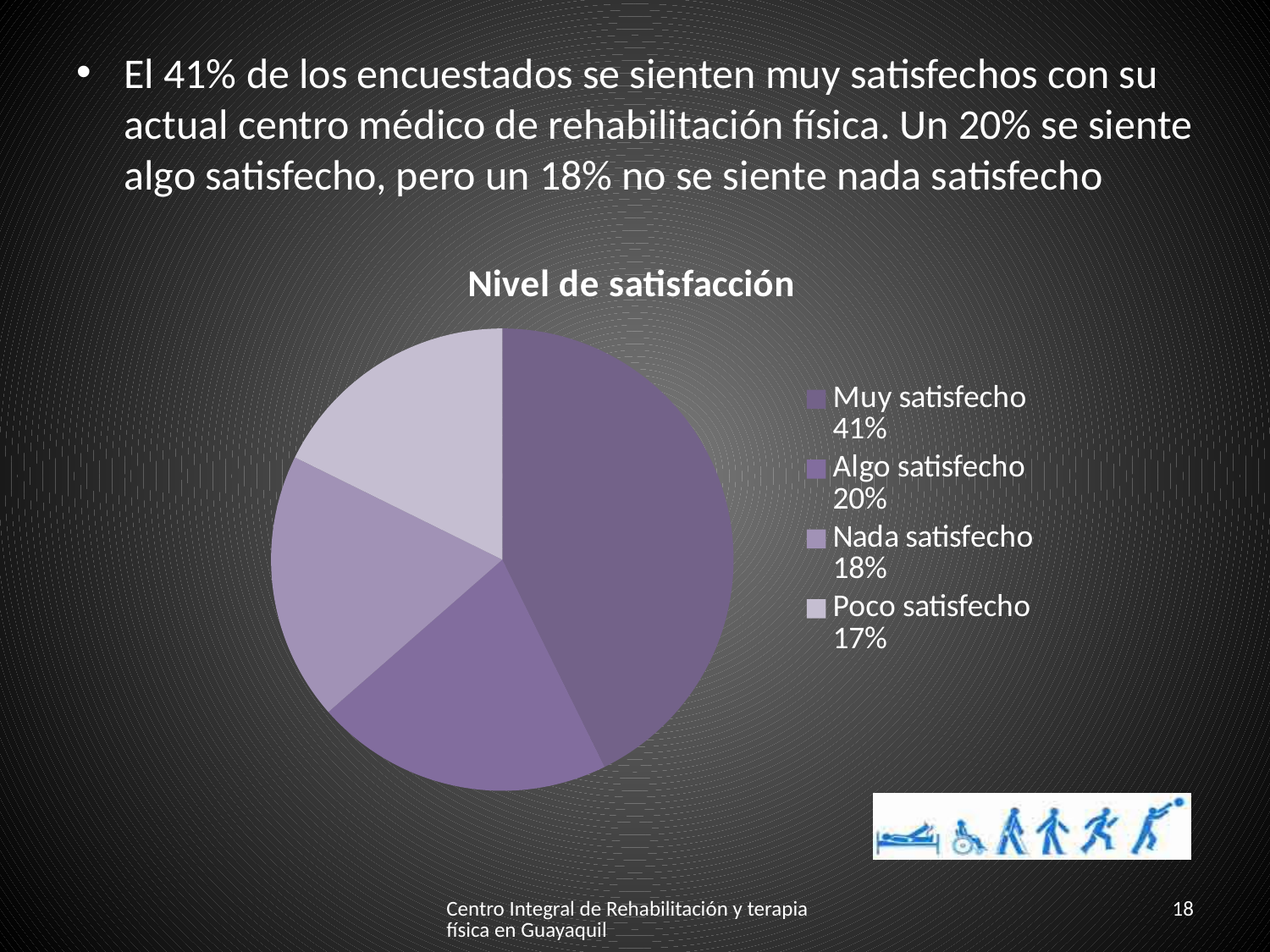
What is the title of the chart? Nivel de satisfacción What is the difference in percentage points between 'Nada satisfecho' and 'Poco satisfecho'? 1 What kind of chart is shown on the slide? pie chart What share of the pie is 'Nada satisfecho'? 18% What share of the pie is 'Poco satisfecho'? 17% Which category has the smallest slice of the pie? Poco satisfecho Which is larger, the share for 'Algo satisfecho' or the share for 'Nada satisfecho'? Algo satisfecho What share of the pie is 'Algo satisfecho'? 20% How many categories does the pie chart show? 4 What is the difference in percentage points between 'Muy satisfecho' and 'Algo satisfecho'? 21 Which category has the largest slice of the pie? Muy satisfecho